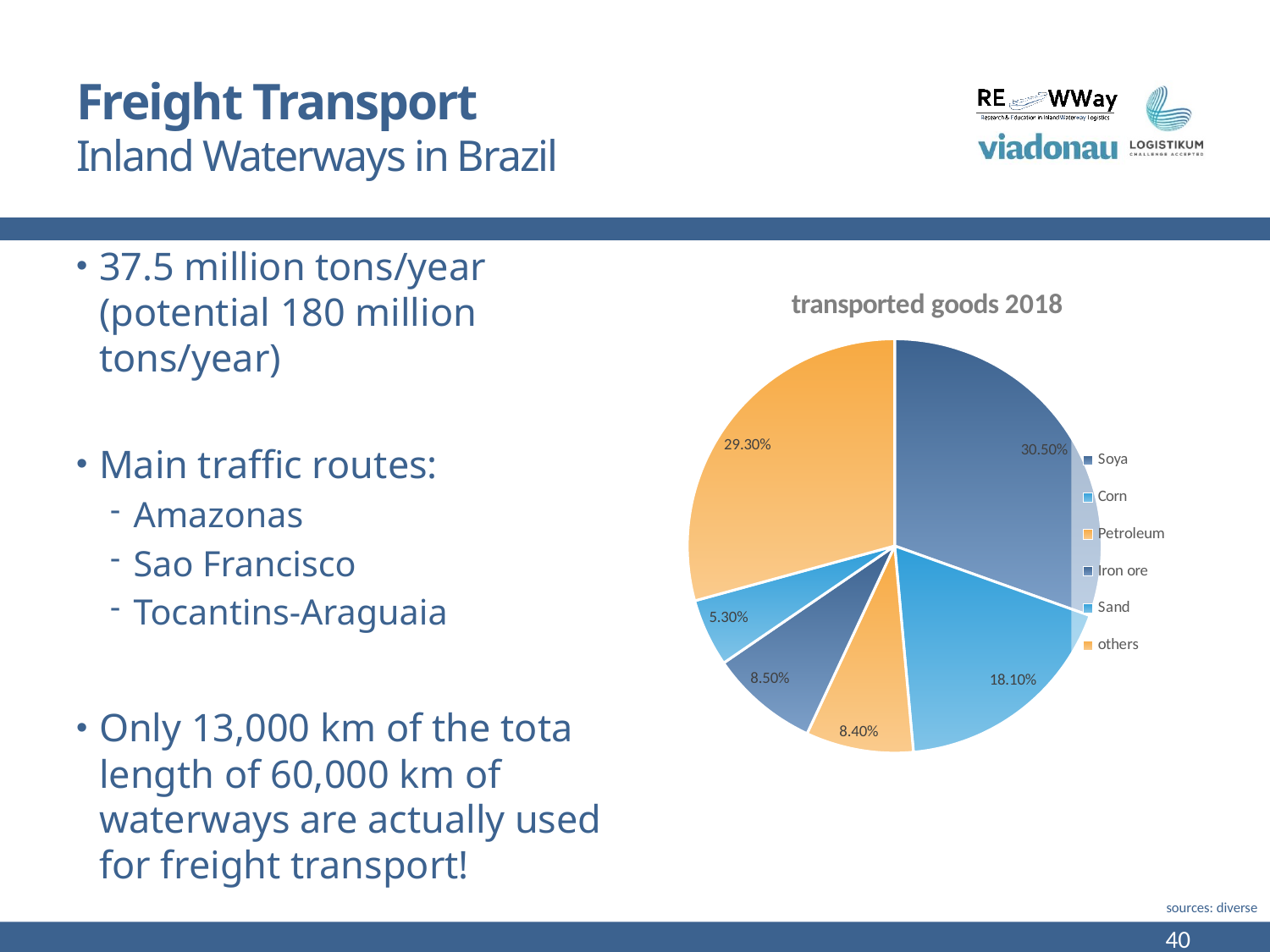
Which has the larger share, Corn or others? others How many categories does the pie chart show? 6 What share of transported goods in 2018 is Sand? 5.30% What share of transported goods in 2018 is Iron ore? 8.50% What share of transported goods in 2018 is Soya? 30.50% What is the title of the chart? transported goods 2018 What is the difference in percentage points between the Soya share and the Corn share? 12.40 Which category has the smallest share of the pie? Sand Which category has the largest share of the pie? Soya What share of transported goods in 2018 is Corn? 18.10% What type of chart is shown on the slide? pie chart What share of transported goods in 2018 is Petroleum? 8.40%